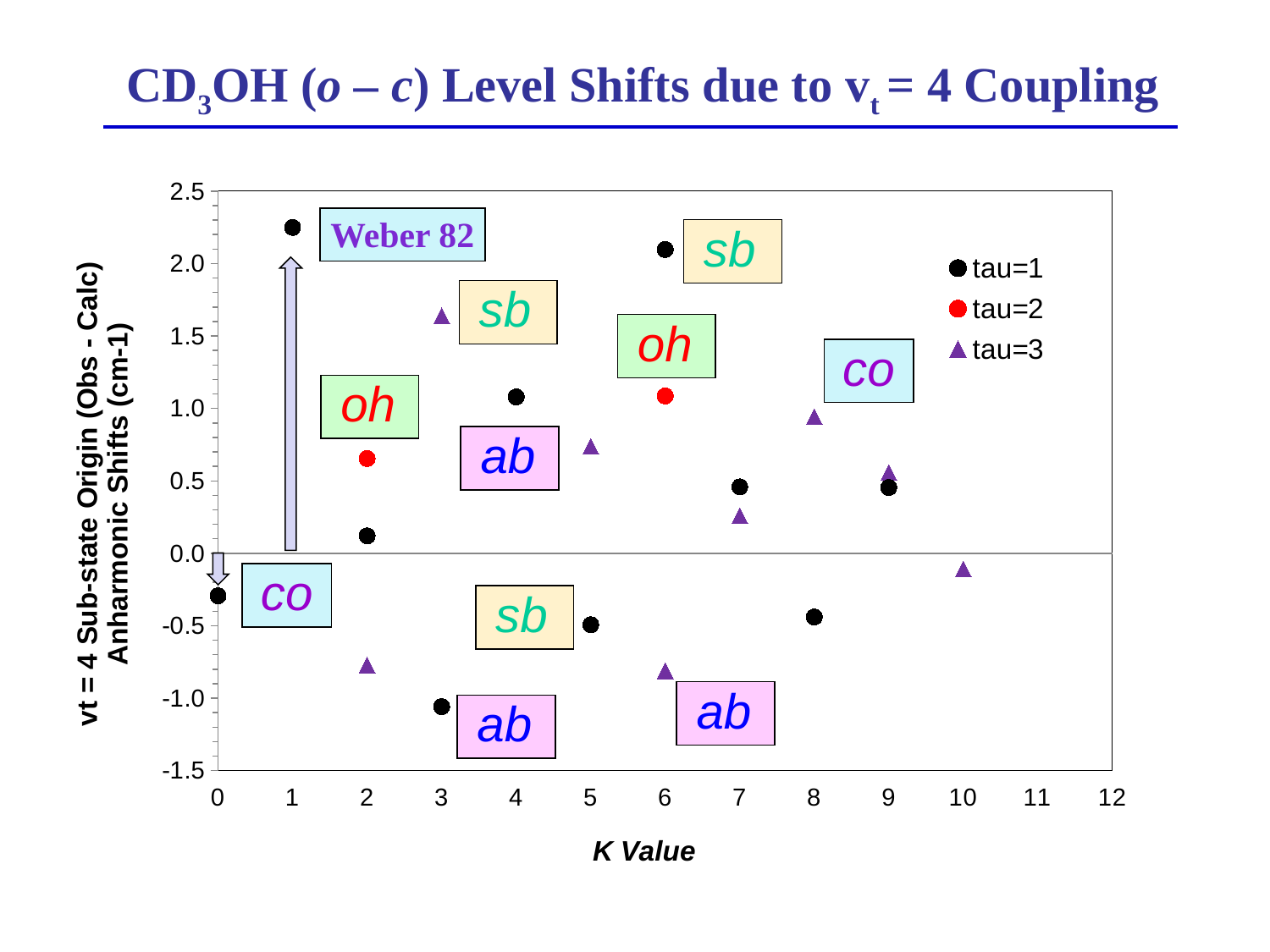
Is the tau=2 value at K = 2 greater or less than 0.5? greater How many data points are plotted for the tau=2 series? 2 What kind of chart is shown on the slide? scatter chart What are the three series named in the legend? tau=1, tau=2, tau=3 How many series does the legend list? 3 At which K value is the tau=1 series lowest? 3 What is the title of the x axis? K Value How many data points are plotted for the tau=1 series? 10 Is the tau=3 value at K = 3 greater or less than 1.5? greater At K = 2, which series has the larger value, tau=1 or tau=2? tau=2 Is the tau=1 value at K = 1 greater or less than 2.0? greater At which K value is the tau=3 series highest? 3